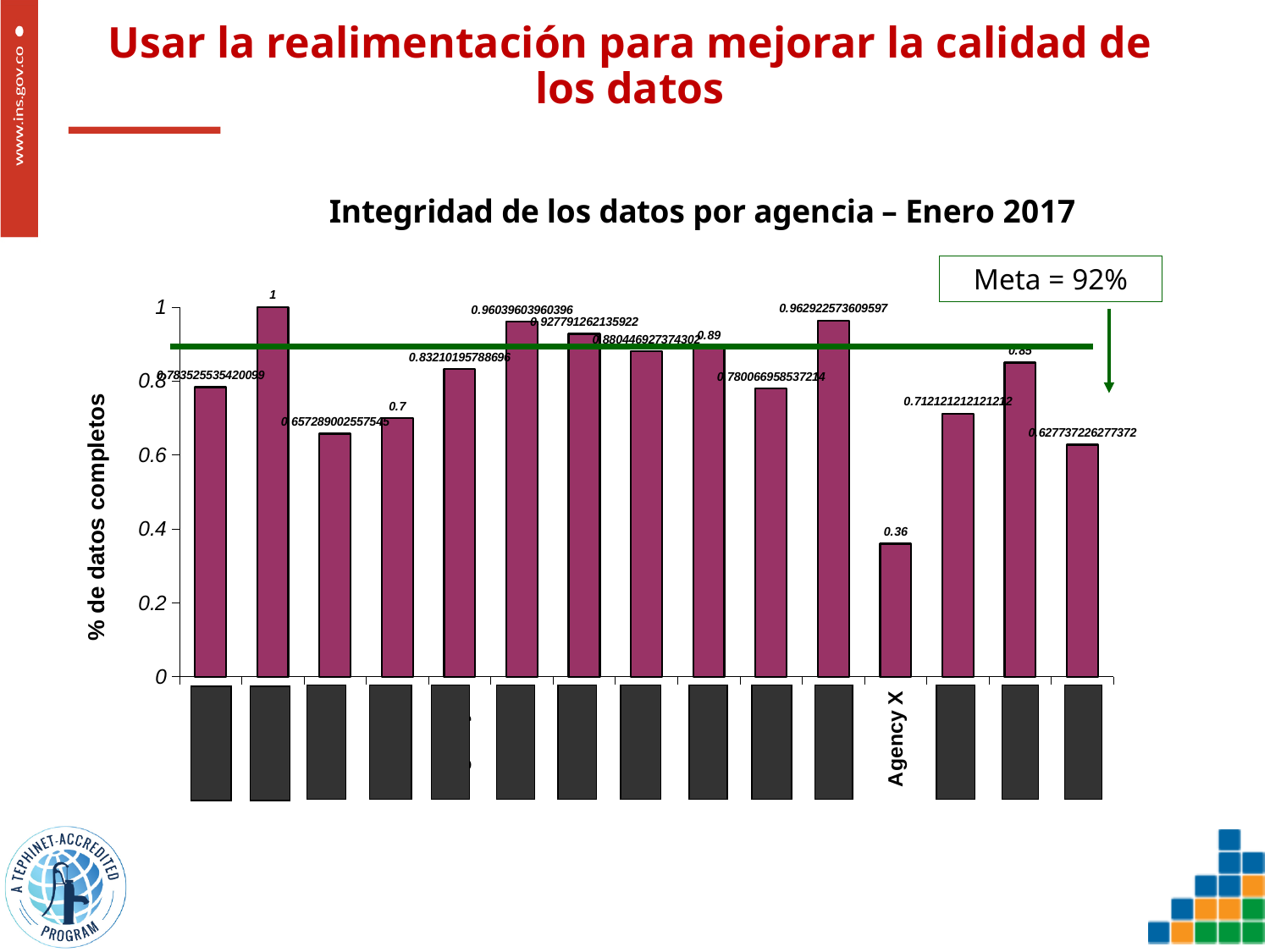
What is the lowest data label value shown in the chart? 0.36 What target (Meta) value is indicated on the chart? 92% Is the value for Agency X greater or less than 0.6? less Which labelled agency has the lowest value in the chart? Agency X What is the value shown for Agency X? 0.36 Is the value for Agency X greater or less than 0.4? less What is the title of the chart? Integridad de los datos por agencia – Enero 2017 How many bars are plotted in the chart? 15 What kind of chart is shown on the slide? bar chart What is the highest data label value shown in the chart? 1